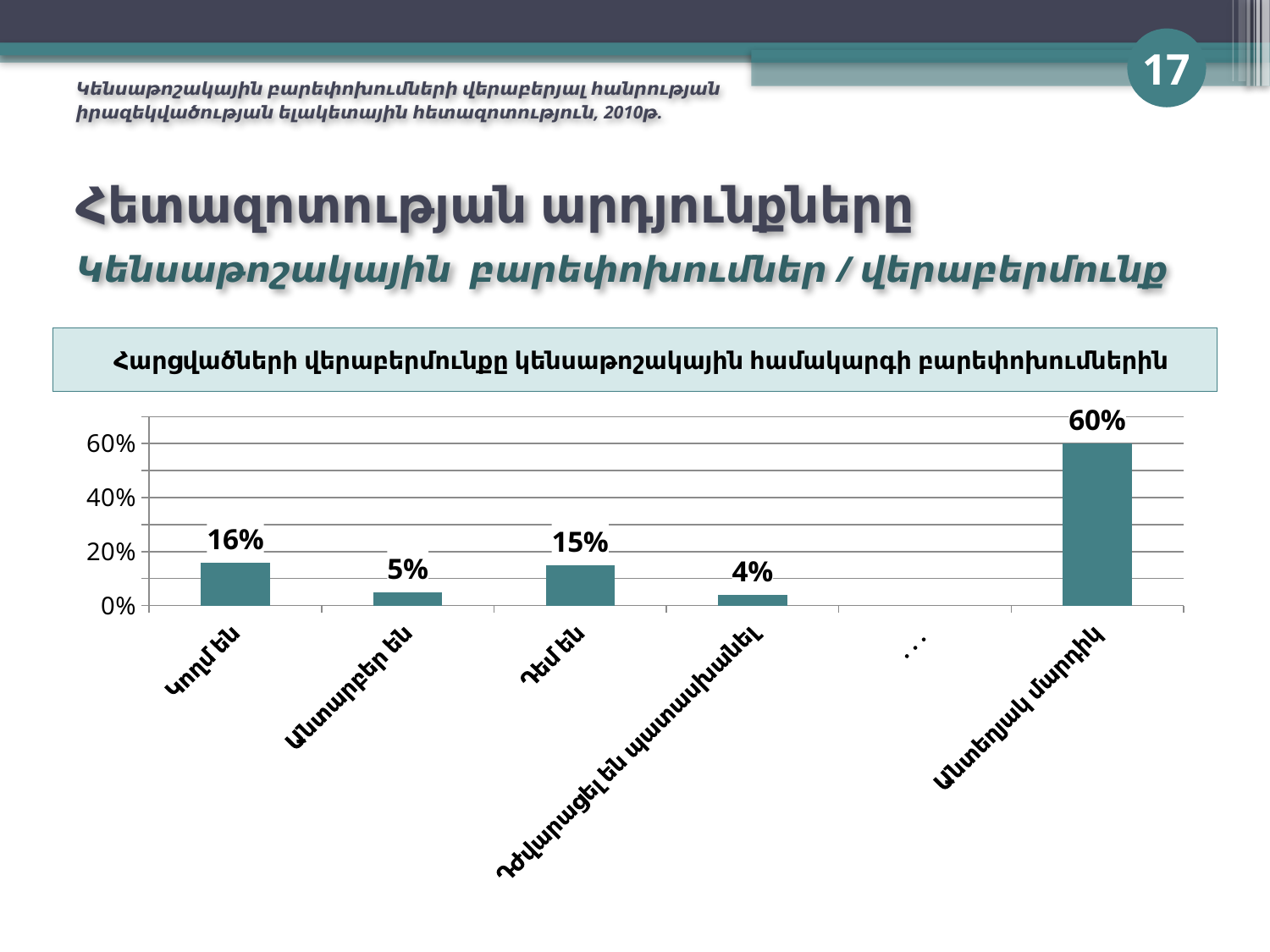
Which is larger, the value for Կողմ են or the value for Դեմ են? Կողմ են What kind of chart is shown on the slide? bar chart What is the value for Դեմ են? 15% What is the value for Դժվարացել են պատասխանել? 4% What is the value for Անտարբեր են? 5% Which category has the lowest value? Դժվարացել են պատասխանել What is the value for Կողմ են? 16% Is the value for Անտեղյակ մարդիկ greater or less than 40%? greater Which category has the highest value? Անտեղյակ մարդիկ What is the value for Անտեղյակ մարդիկ? 60% How many bars are plotted in the chart? 5 What is the difference between the values for Անտեղյակ մարդիկ and Կողմ են? 44%